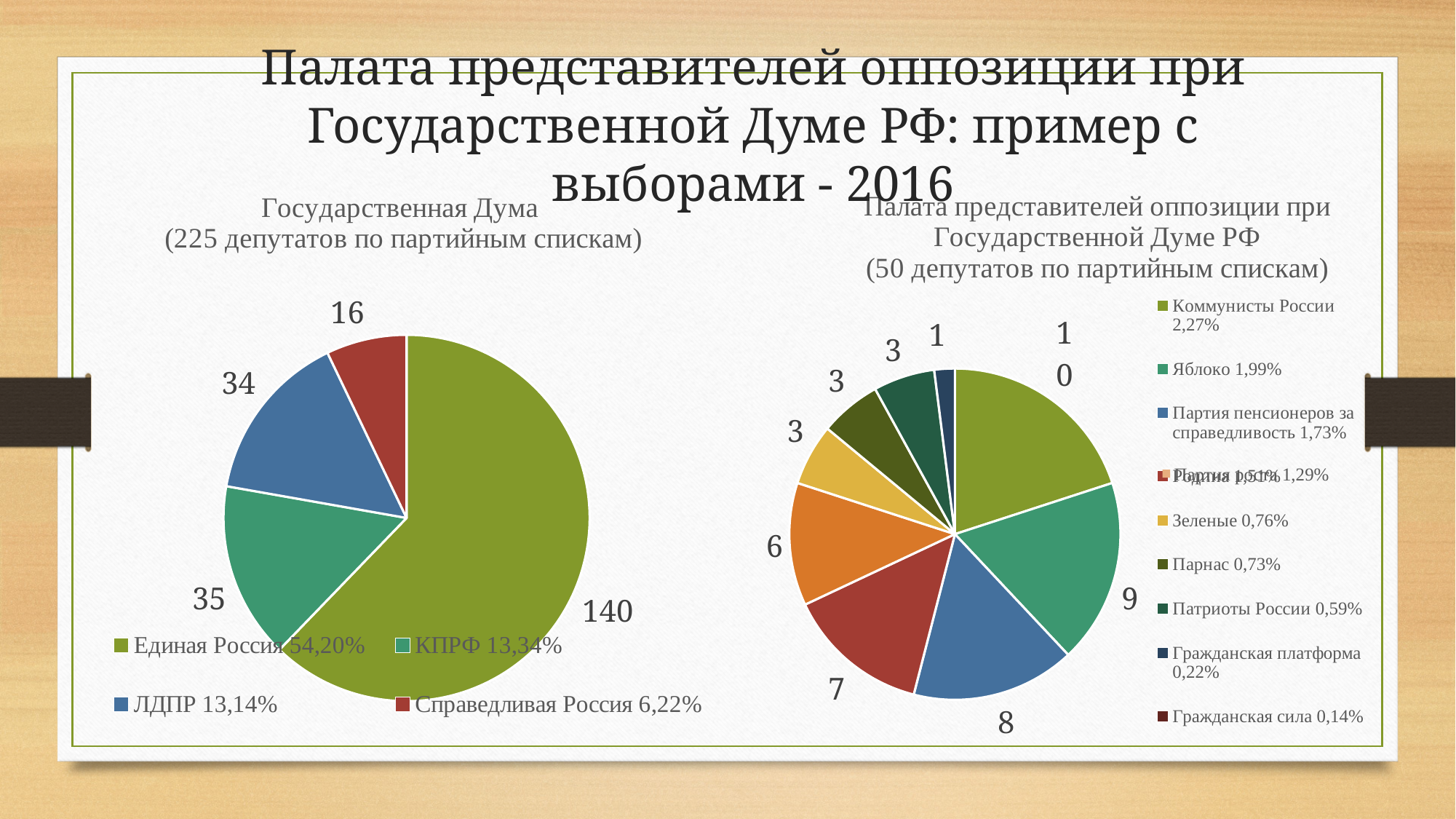
In the left pie chart (Государственная Дума), how many deputies does Единая Россия have? 140 In the left pie chart (Государственная Дума), how many slices does the pie have? 4 In the right pie chart (Палата представителей оппозиции), which is larger: Партия пенсионеров за справедливость or Зеленые? Партия пенсионеров за справедливость In the left pie chart (Государственная Дума), what percentage is shown in the legend for Единая Россия? 54,20% In the left pie chart (Государственная Дума), what is the difference between the values for ЛДПР and Справедливая Россия? 18 In the left pie chart (Государственная Дума), how many deputies does КПРФ have? 35 What type of chart is the chart on the right (Палата представителей оппозиции)? pie chart In the right pie chart (Палата представителей оппозиции), what percentage is shown in the legend for Парнас? 0,73% In the right pie chart (Палата представителей оппозиции), what is the value for Яблоко? 9 In the left pie chart (Государственная Дума), which party has the smallest slice? Справедливая Россия In the right pie chart (Палата представителей оппозиции), what is the difference between the values for Коммунисты России and Гражданская платформа? 9 In the right pie chart (Палата представителей оппозиции), which party has the largest slice? Коммунисты России